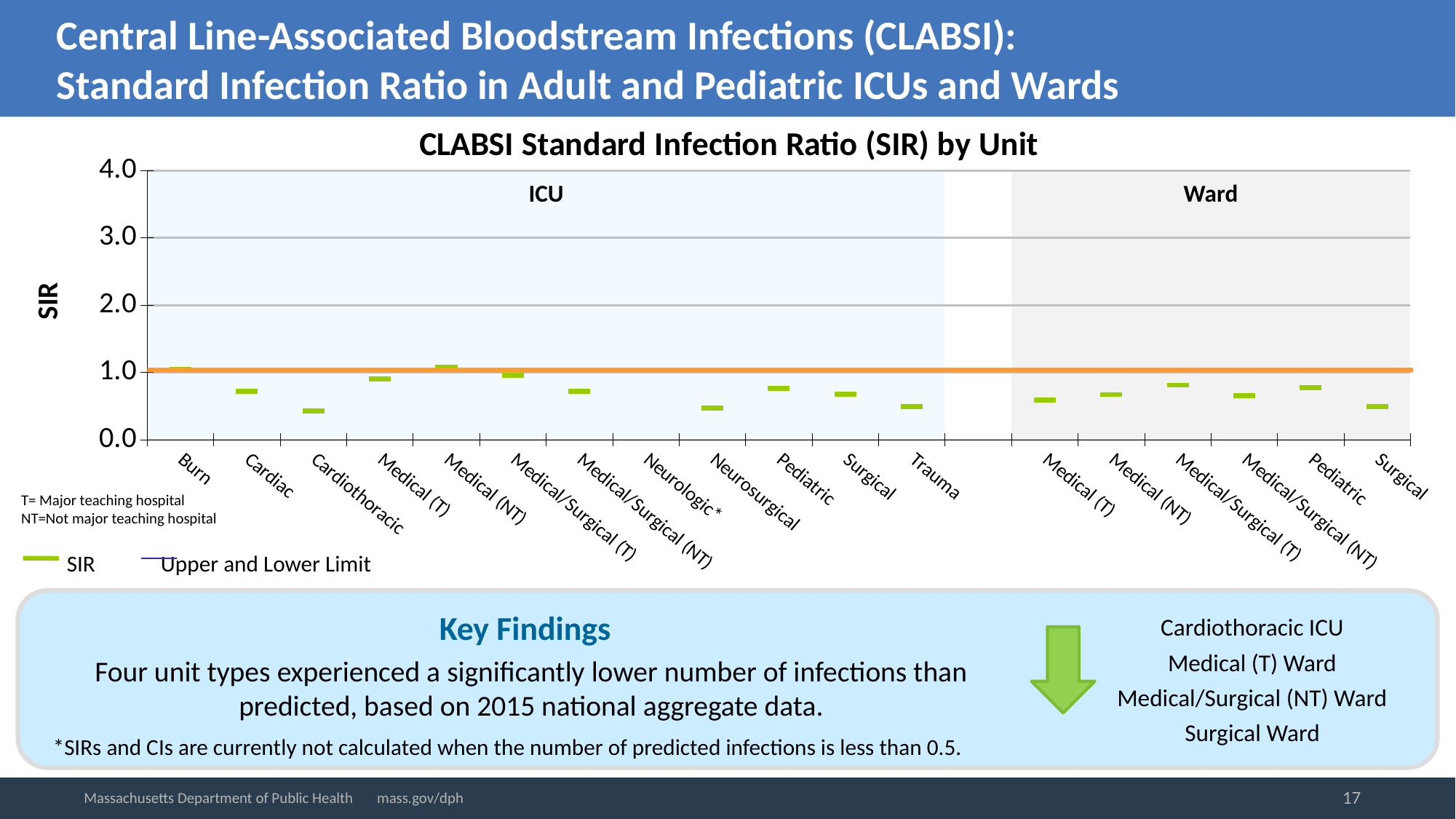
Which ICU unit category has no SIR marker plotted on the chart? Neurologic * Is the SIR value for the Cardiothoracic ICU greater or less than 1.0? less What is the title of the chart? CLABSI Standard Infection Ratio (SIR) by Unit How many unit categories are shown in the ICU section of the chart? 12 How many unit categories are shown in the Ward section of the chart? 6 Which has the larger SIR value, the Cardiac ICU or the Medical (T) ICU? Medical (T) ICU What is the label on the vertical axis of the chart? SIR Which has the larger SIR value, the Cardiothoracic ICU or the Medical (NT) ICU? Medical (NT) ICU Is the SIR value for the Trauma ICU greater or less than 1.0? less Is the SIR value for the Medical (NT) ICU greater or less than 1.0? greater How many series does the chart legend list? 2